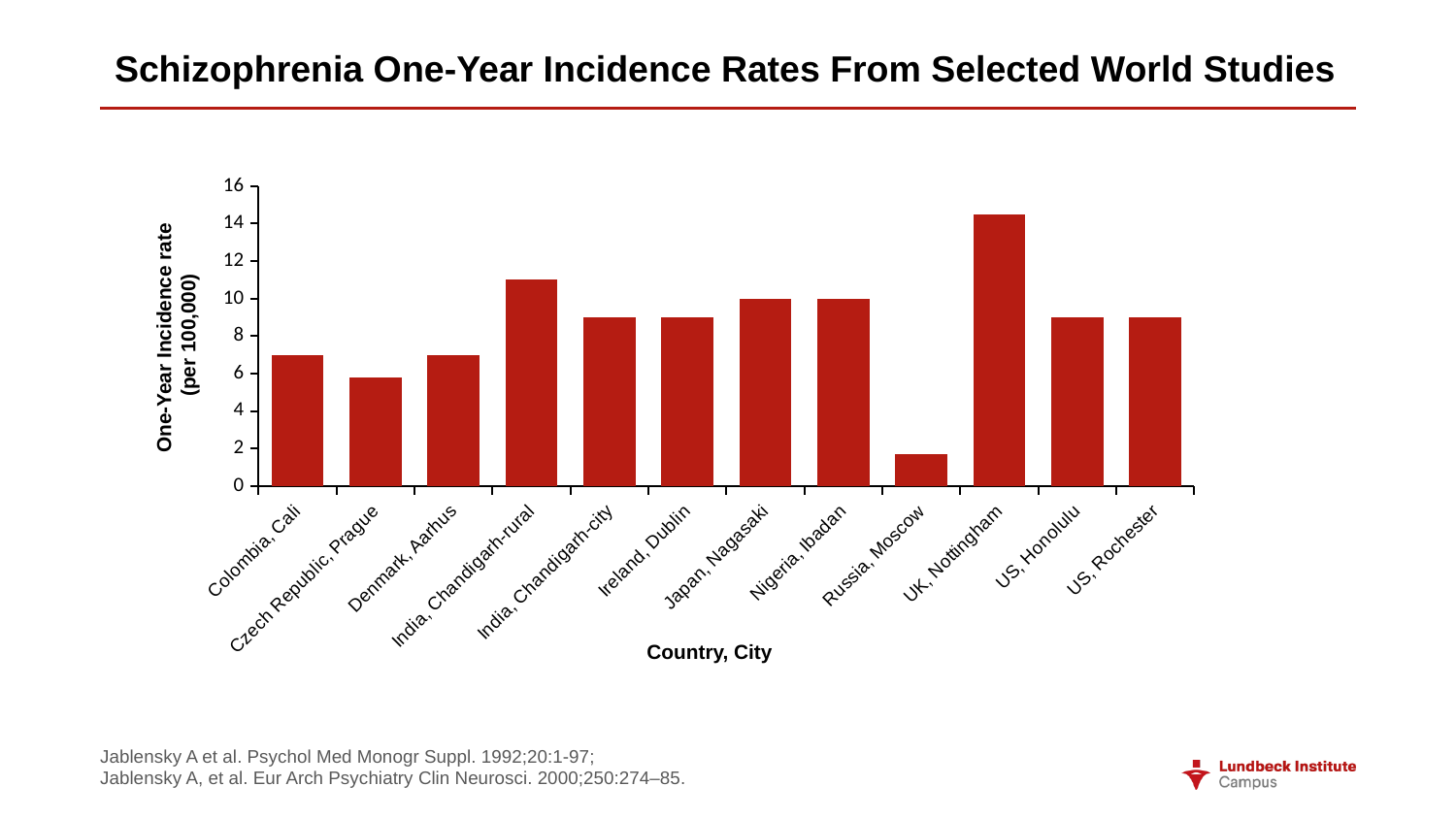
What is the title of the vertical axis? One-Year Incidence rate (per 100,000) Is the value for Czech Republic, Prague greater or less than 8? less Is the value for UK, Nottingham greater or less than 12? greater How many country/city categories are plotted on the chart? 12 Which country/city has the highest one-year incidence rate? UK, Nottingham Which has a higher one-year incidence rate, India, Chandigarh-rural or India, Chandigarh-city? India, Chandigarh-rural Is the value for Russia, Moscow greater or less than 2? less Which country/city has the lowest one-year incidence rate? Russia, Moscow Which has a higher one-year incidence rate, UK, Nottingham or Japan, Nagasaki? UK, Nottingham What is the title of the horizontal axis? Country, City What kind of chart is shown on the slide? Bar chart